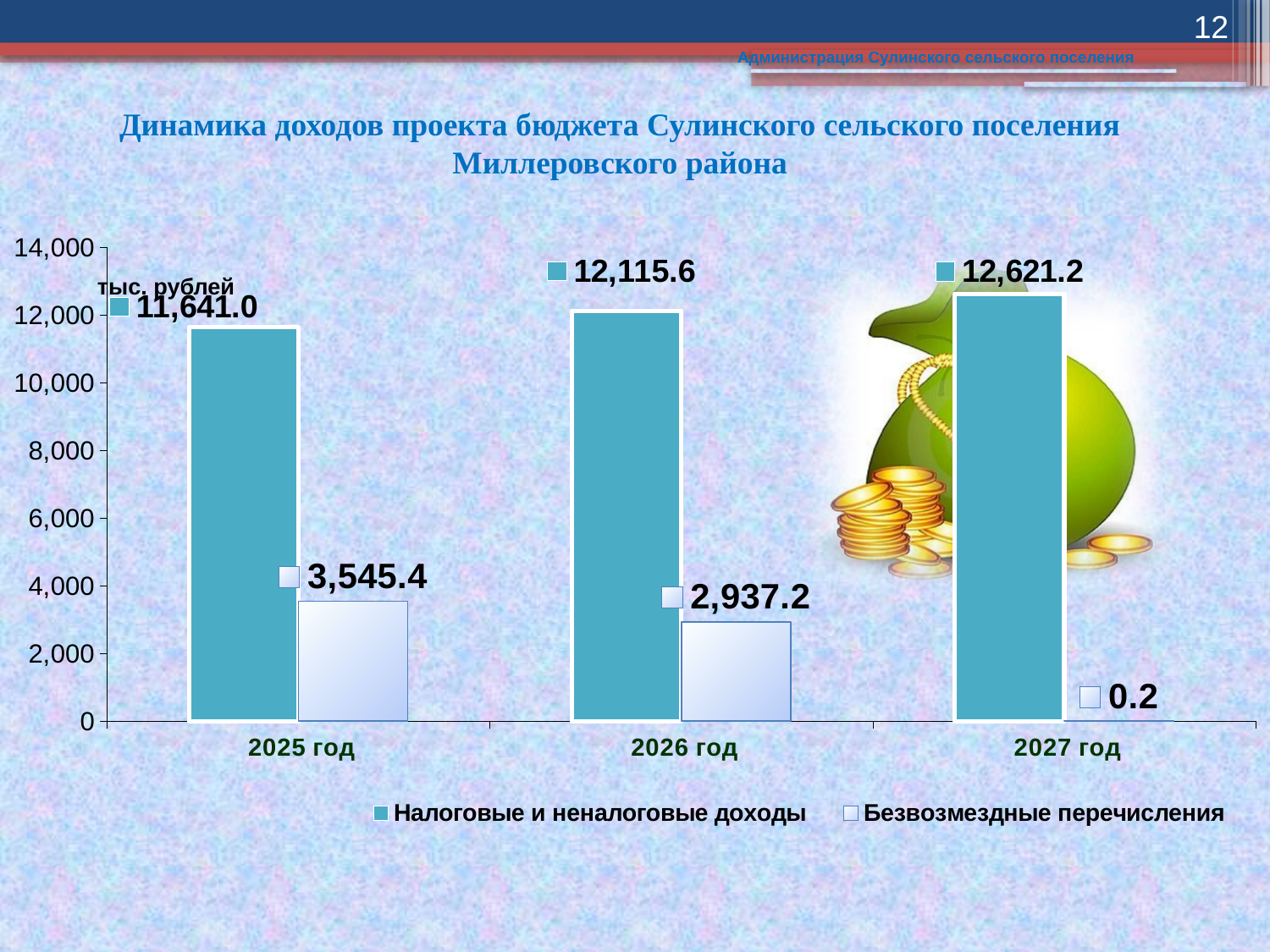
How many series does the legend list? 2 What is the value of Безвозмездные перечисления for 2026 год? 2,937.2 What kind of chart is shown on the slide? bar chart What is the value of Безвозмездные перечисления for 2027 год? 0.2 How many years are shown on the x axis? 3 What is the value of Налоговые и неналоговые доходы for 2025 год? 11,641.0 Is the value of Налоговые и неналоговые доходы for 2026 год greater or less than 12,000? greater What is the difference between Налоговые и неналоговые доходы in 2027 год and 2026 год? 505.6 Does Налоговые и неналоговые доходы rise or fall from 2025 год to 2027 год? rise Which is larger: Безвозмездные перечисления in 2025 год or in 2026 год? 2025 год In which year is Налоговые и неналоговые доходы highest? 2027 год In which year is Безвозмездные перечисления lowest? 2027 год